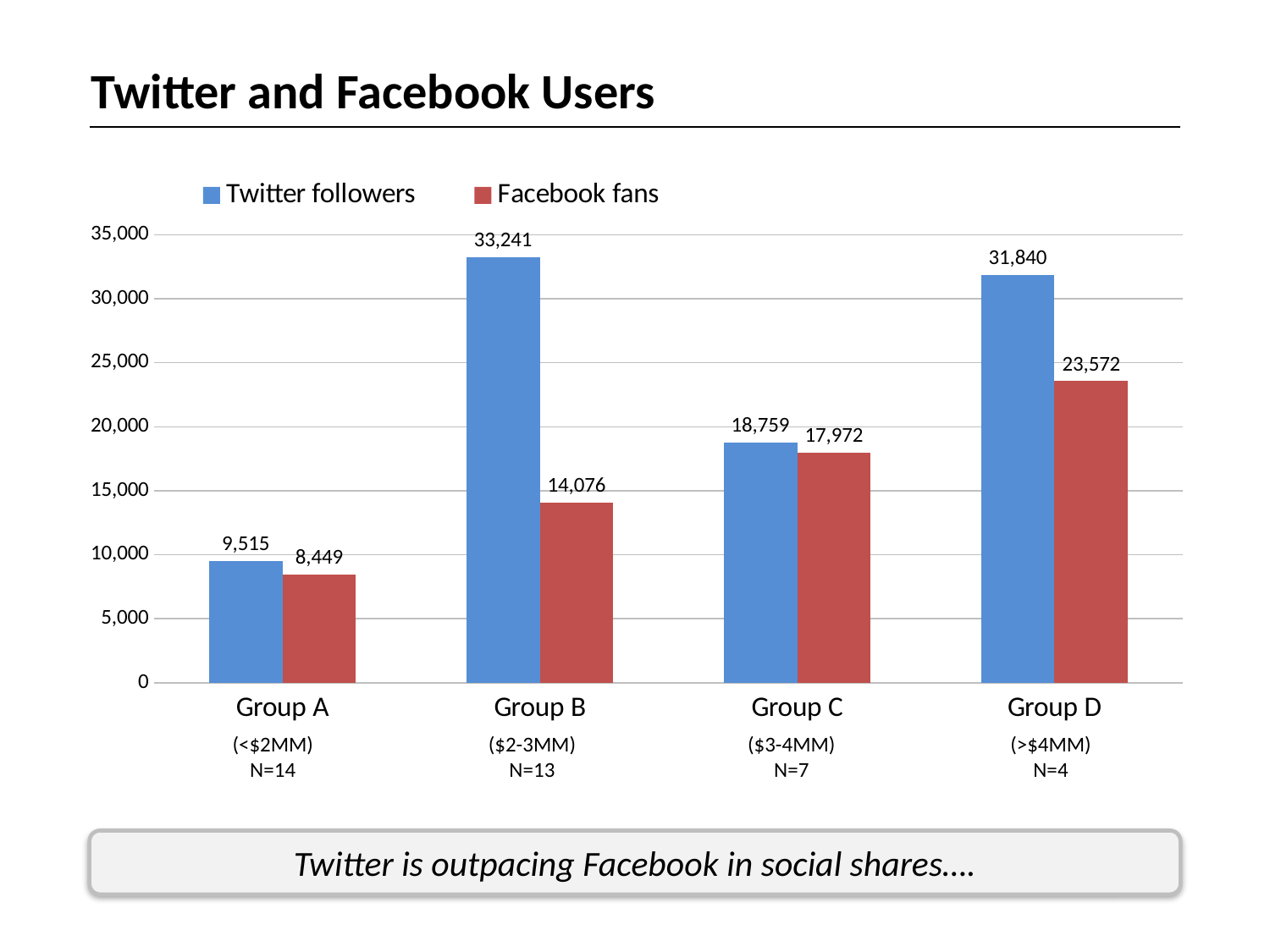
How many Twitter followers does Group B have? 33,241 How many series does the legend list? 2 What kind of chart is shown on the slide? Bar chart What is the difference between Twitter followers and Facebook fans for Group D? 8,268 How many Facebook fans does Group D have? 23,572 What is the title of the slide? Twitter and Facebook Users Which is larger for Group C: Twitter followers or Facebook fans? Twitter followers What is the difference between Twitter followers and Facebook fans for Group B? 19,165 How many groups are shown on the x axis? 4 Which group has the highest number of Twitter followers? Group B How many Facebook fans does Group A have? 8,449 Which group has the lowest number of Facebook fans? Group A